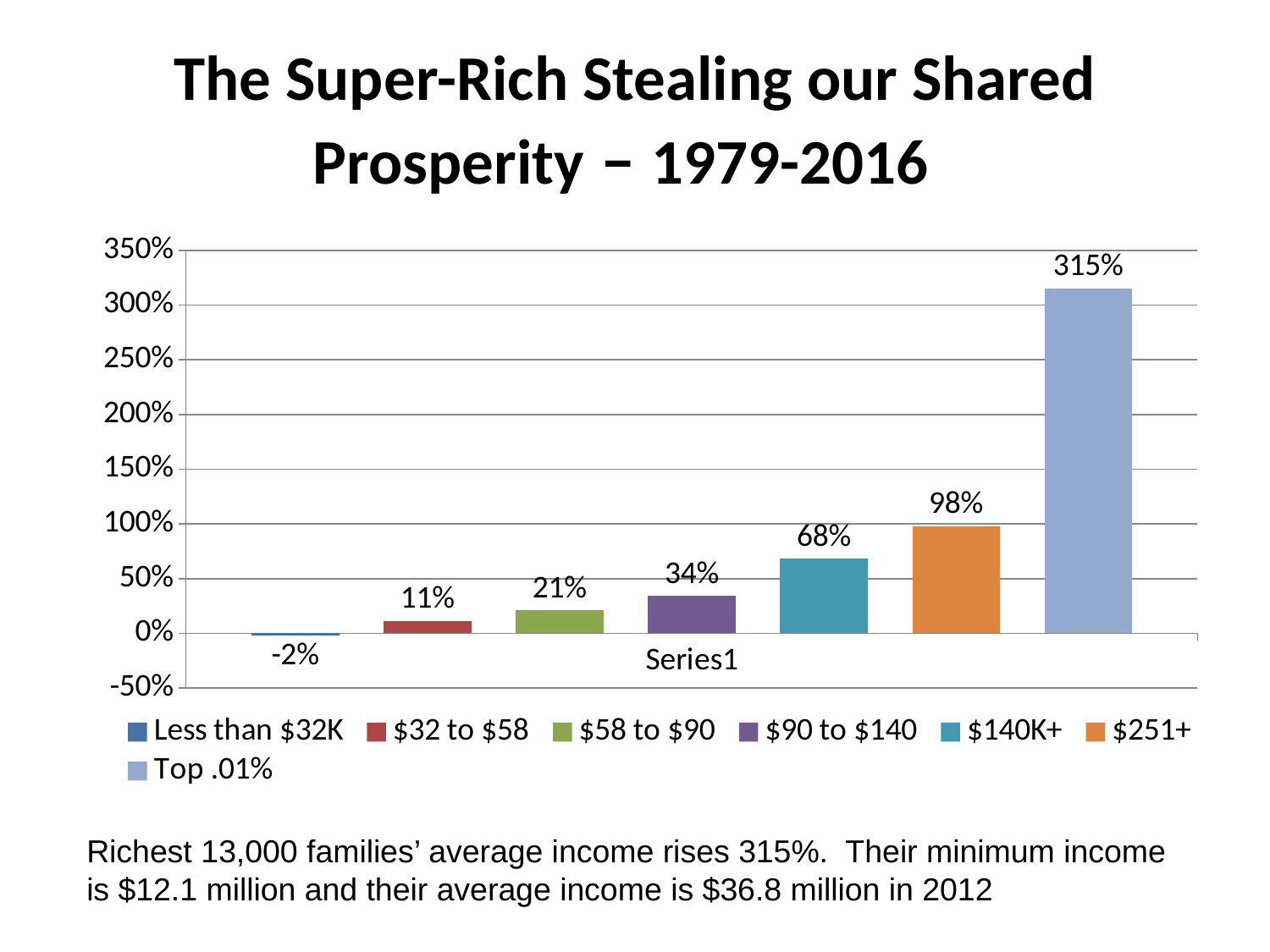
Which is larger, the value for $32 to $58 or the value for $58 to $90? $58 to $90 Do the values rise or fall from left to right across the bars? rise What is the value for the $140K+ group? 68% What kind of chart is shown on the slide? bar chart Which group has the lowest value? Less than $32K Is the value for $251+ greater or less than 100%? less Which group has the highest value? Top .01% What is the difference between the values for Top .01% and $251+? 217% What is the difference between the values for $140K+ and $58 to $90? 47% What is the value for the $90 to $140 group? 34% How many bars are plotted in the chart? 7 What is the value for the Less than $32K group? -2%